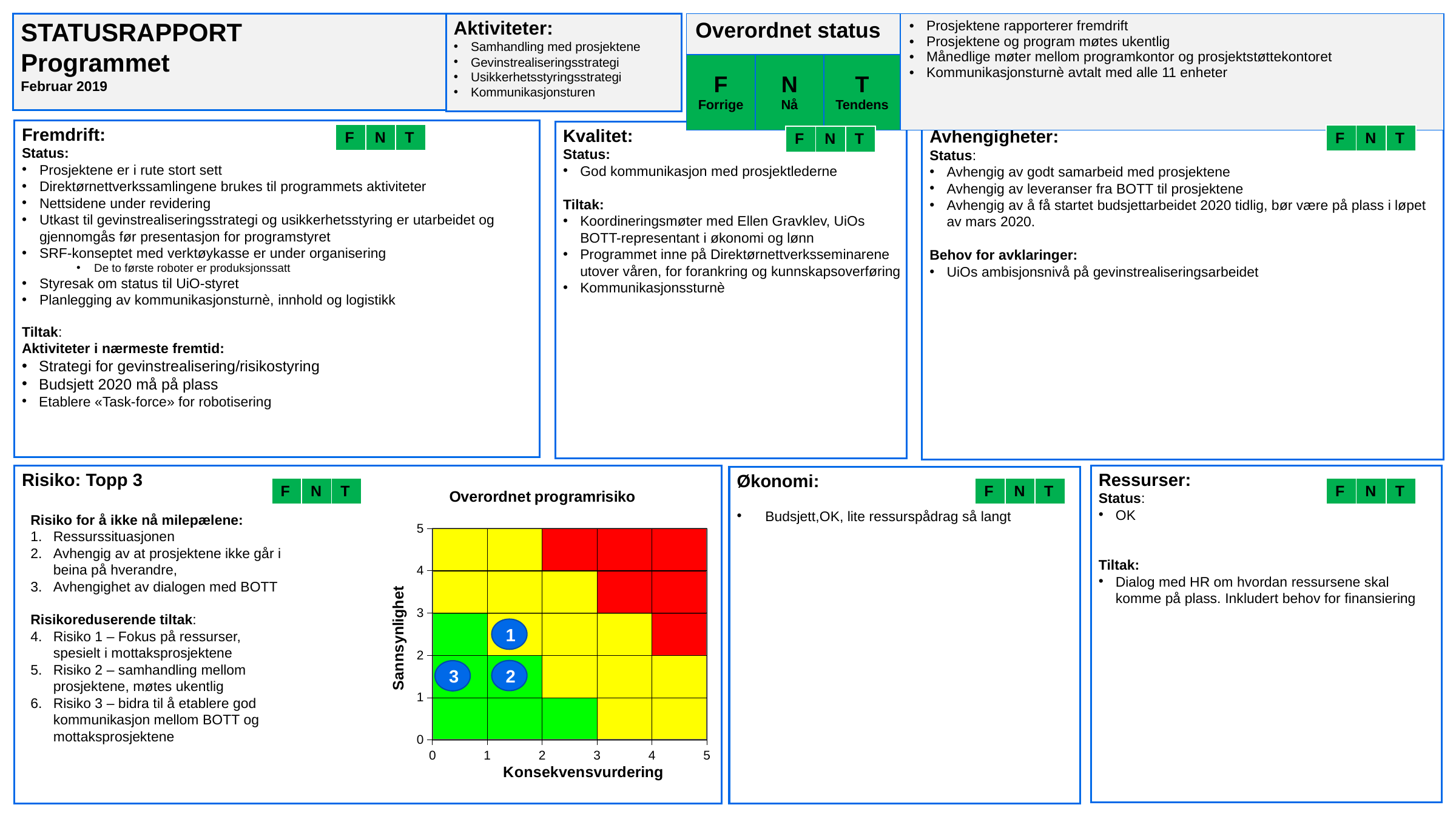
Is the Sannsynlighet value for risk point 3 greater or less than 1? greater Is the Konsekvensvurdering value for risk point 3 greater or less than 1? less Is the Sannsynlighet value for risk point 1 greater or less than 2? greater How many numbered risk points are plotted on the chart? 3 What is the maximum value shown on the y axis (Sannsynlighet) of the chart? 5 What is the title of the chart on the slide? Overordnet programrisiko Which risk point has the highest Sannsynlighet value? 1 Which risk point has the lowest Konsekvensvurdering value? 3 Which has the higher Sannsynlighet value, risk point 1 or risk point 2? Risk point 1 What is the label of the x axis of the chart? Konsekvensvurdering